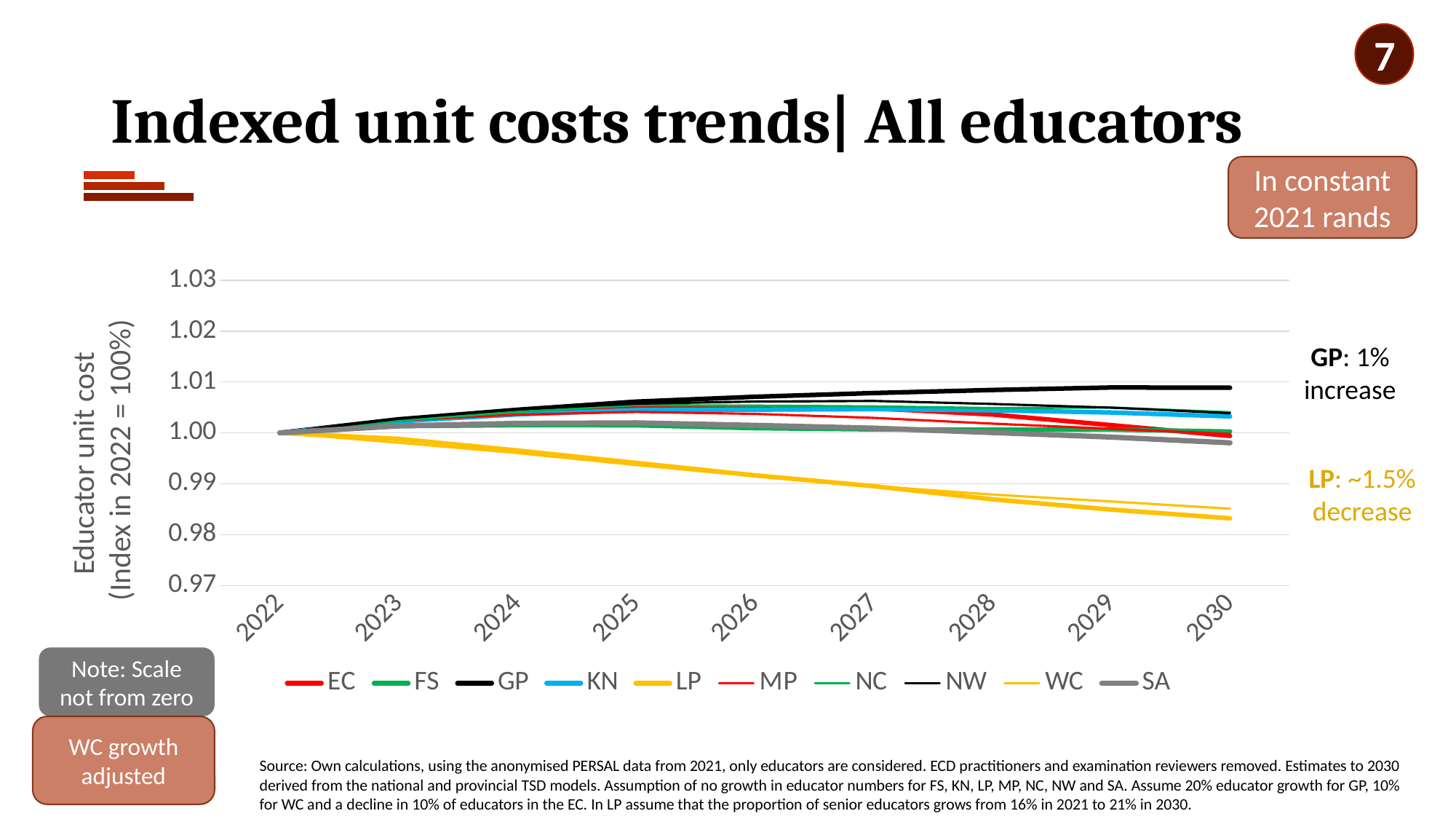
Is the value for GP in 2030 greater or less than 1.00? greater How many years are shown along the x axis? 9 Is the value for LP in 2030 greater or less than 0.99? less Does the LP line rise or fall from 2022 to 2030? fall Which series has the lowest value in 2030? LP What is the educator unit cost index value for all series in 2022? 1.00 Which series has the highest value in 2030? GP What is the y-axis title of the chart? Educator unit cost (Index in 2022 = 100%) How many series does the legend list? 10 Does the GP line rise or fall from 2022 to 2030? rise Which is larger in 2030, the value for GP or the value for LP? GP What type of chart is shown on the slide? line chart